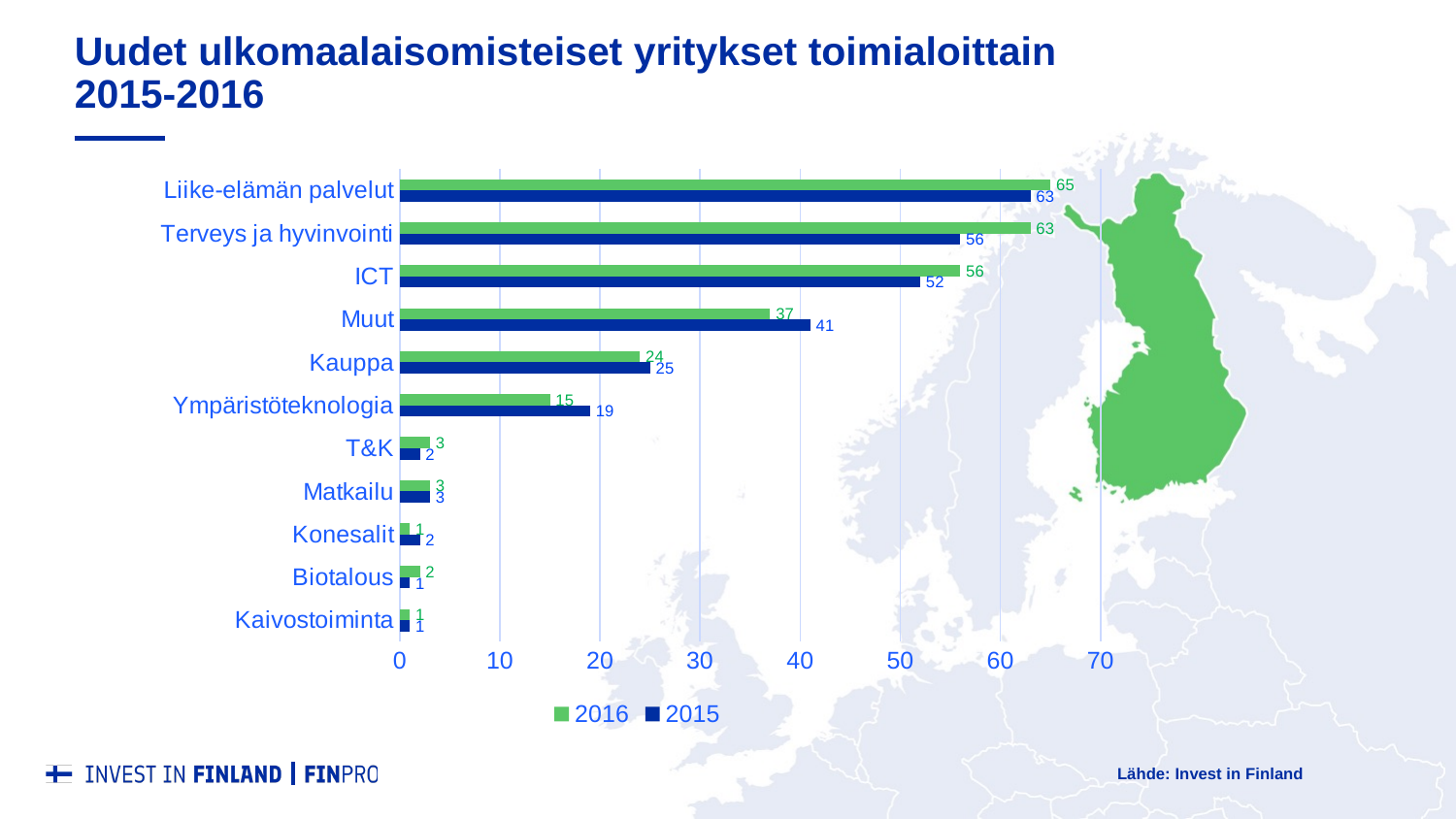
What is the 2016 value for Ympäristöteknologia? 15 How many series does the legend list? 2 What is the difference between the 2016 values for Liike-elämän palvelut and Terveys ja hyvinvointi? 2 What is the 2015 value for Muut? 41 What is the difference between the 2016 and 2015 values for ICT? 4 How many categories are shown on the chart? 11 For Muut, which year has the larger value, 2016 or 2015? 2015 Which category has the highest 2016 value? Liike-elämän palvelut Is the 2015 value for Kauppa greater or less than 30? less What is the 2015 value for Terveys ja hyvinvointi? 56 What is the 2016 value for Liike-elämän palvelut? 65 What kind of chart is shown on the slide? Bar chart